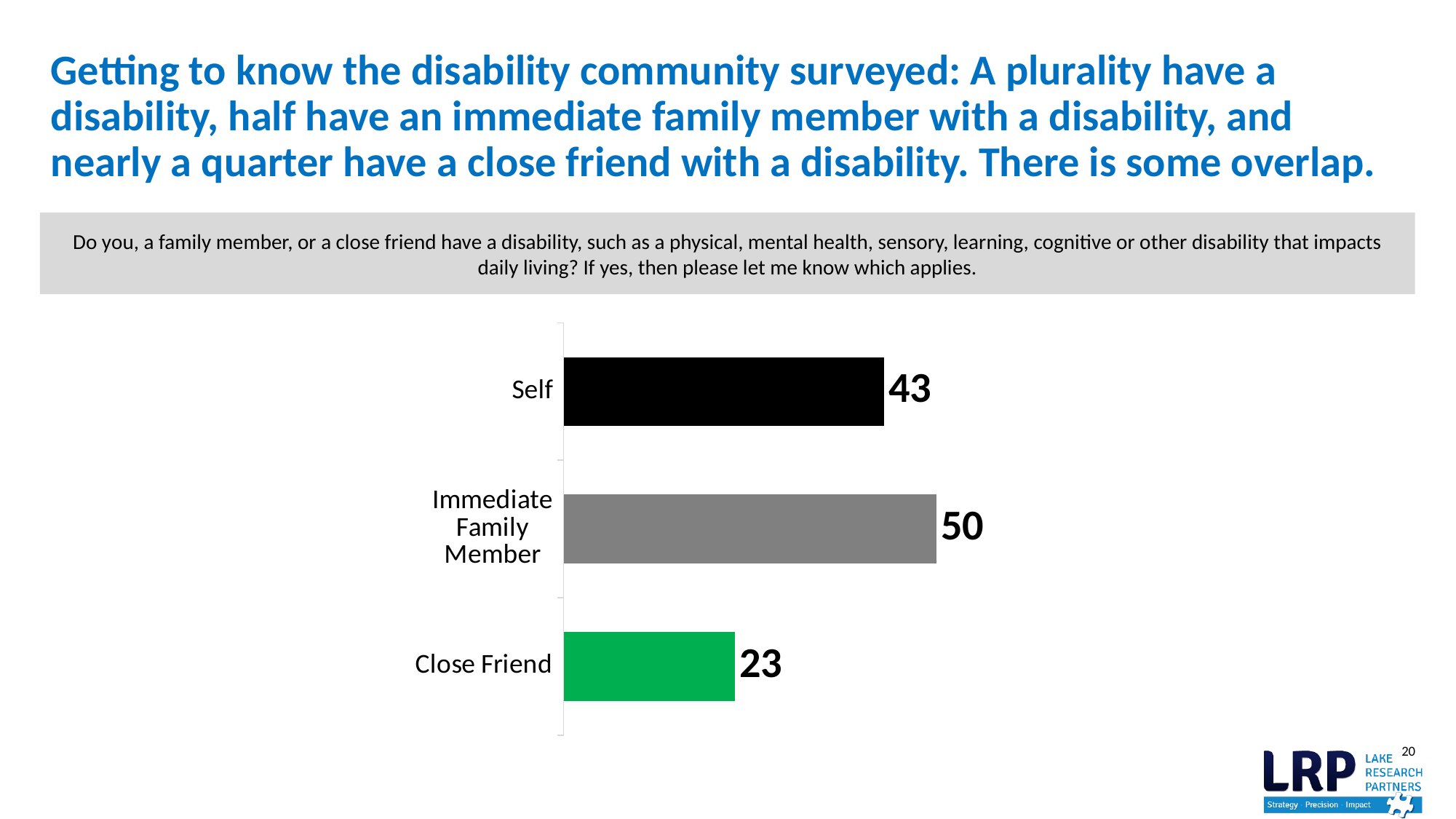
What is the value for Immediate Family Member? 50 What is the value for Self? 43 Which is larger, the value for Self or the value for Close Friend? Self What is the value for Close Friend? 23 How many categories are shown in the chart? 3 What is the difference between the values for Self and Close Friend? 20 Which category has the highest value? Immediate Family Member Which category has the lowest value? Close Friend What kind of chart is shown on the slide? Bar chart What colour is the bar for Close Friend? Green What is the difference between the values for Immediate Family Member and Self? 7 What colour is the bar for Self? Black